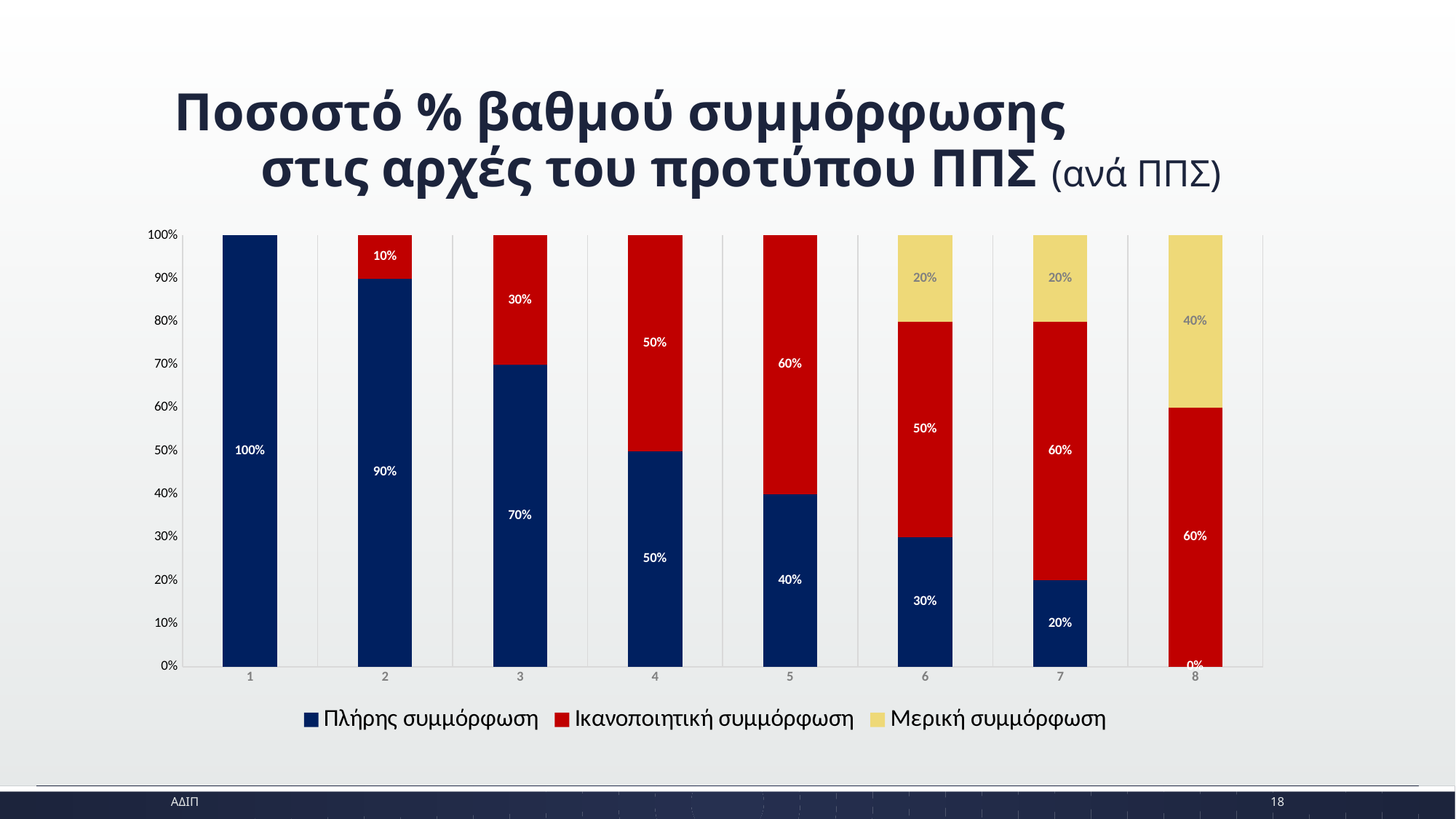
What kind of chart is shown on the slide? Stacked bar chart How many categories are shown on the x axis? 8 What is the value of Πλήρης συμμόρφωση for category 3? 70% What is the value of Πλήρης συμμόρφωση for category 8? 0% How many series does the legend list? 3 What is the difference between the Πλήρης συμμόρφωση values for category 2 and category 6? 60% Which is larger: Ικανοποιητική συμμόρφωση for category 4 or for category 7? Category 7 Which category has the lowest value for Πλήρης συμμόρφωση? 8 Does the value of Πλήρης συμμόρφωση rise or fall from category 1 to category 8? Fall What is the value of Μερική συμμόρφωση for category 8? 40% What is the value of Ικανοποιητική συμμόρφωση for category 5? 60% Which category has the highest value for Πλήρης συμμόρφωση? 1